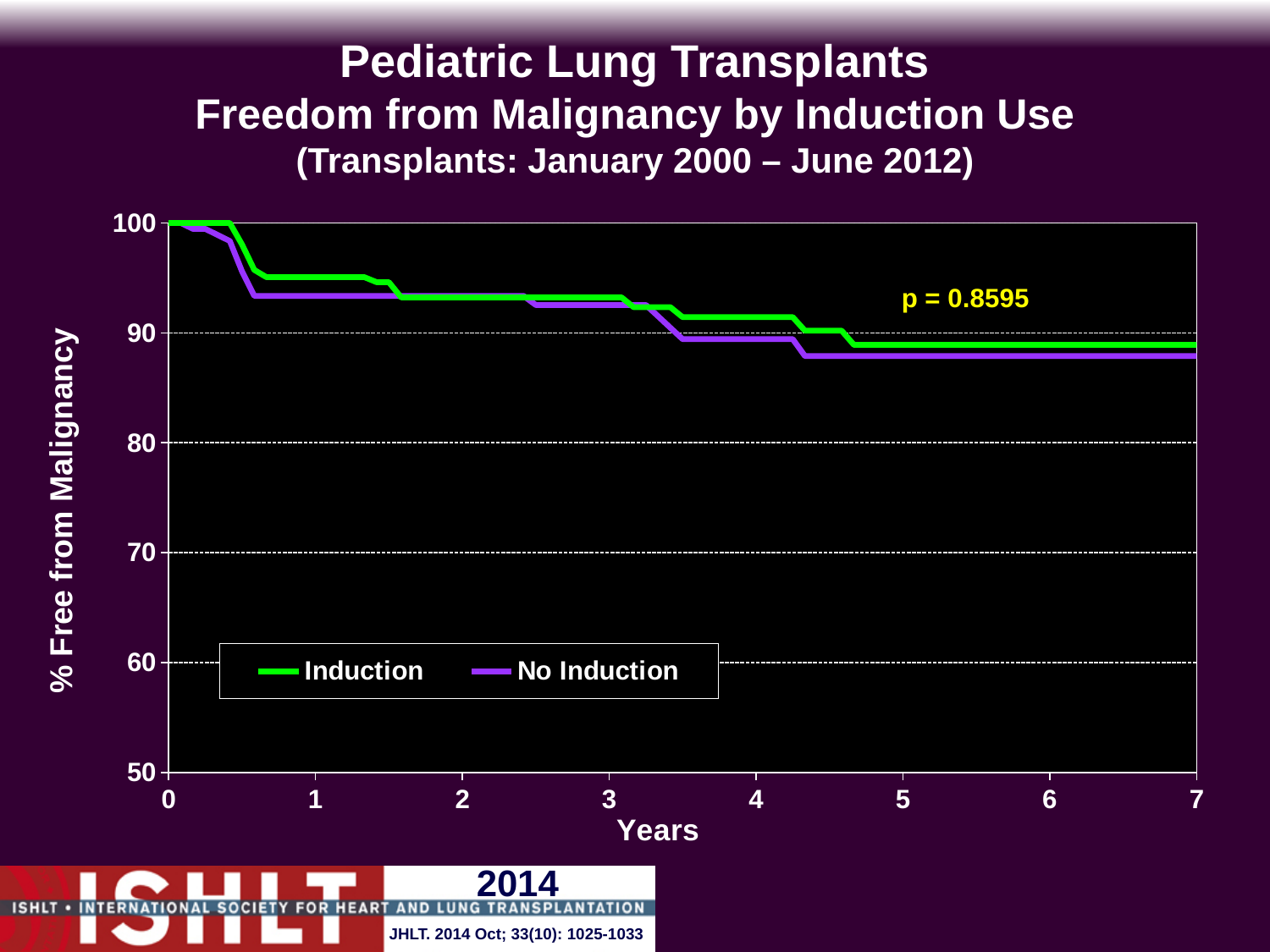
At year 1, which series has the higher % free from malignancy, Induction or No Induction? Induction Is the value for Induction at year 7 greater or less than 80? greater Is the value for No Induction at year 7 greater or less than 90? less How many series does the legend list? 2 At year 7, which series has the higher % free from malignancy, Induction or No Induction? Induction Do the values for the Induction series rise or fall as years increase? Fall What p-value is printed on the chart? p = 0.8595 Do the values for the No Induction series rise or fall as years increase? Fall What is the label of the x axis? Years What kind of chart is shown on the slide? Line chart Which two series are listed in the legend? Induction and No Induction Is the value for No Induction at year 2 greater or less than 90? greater